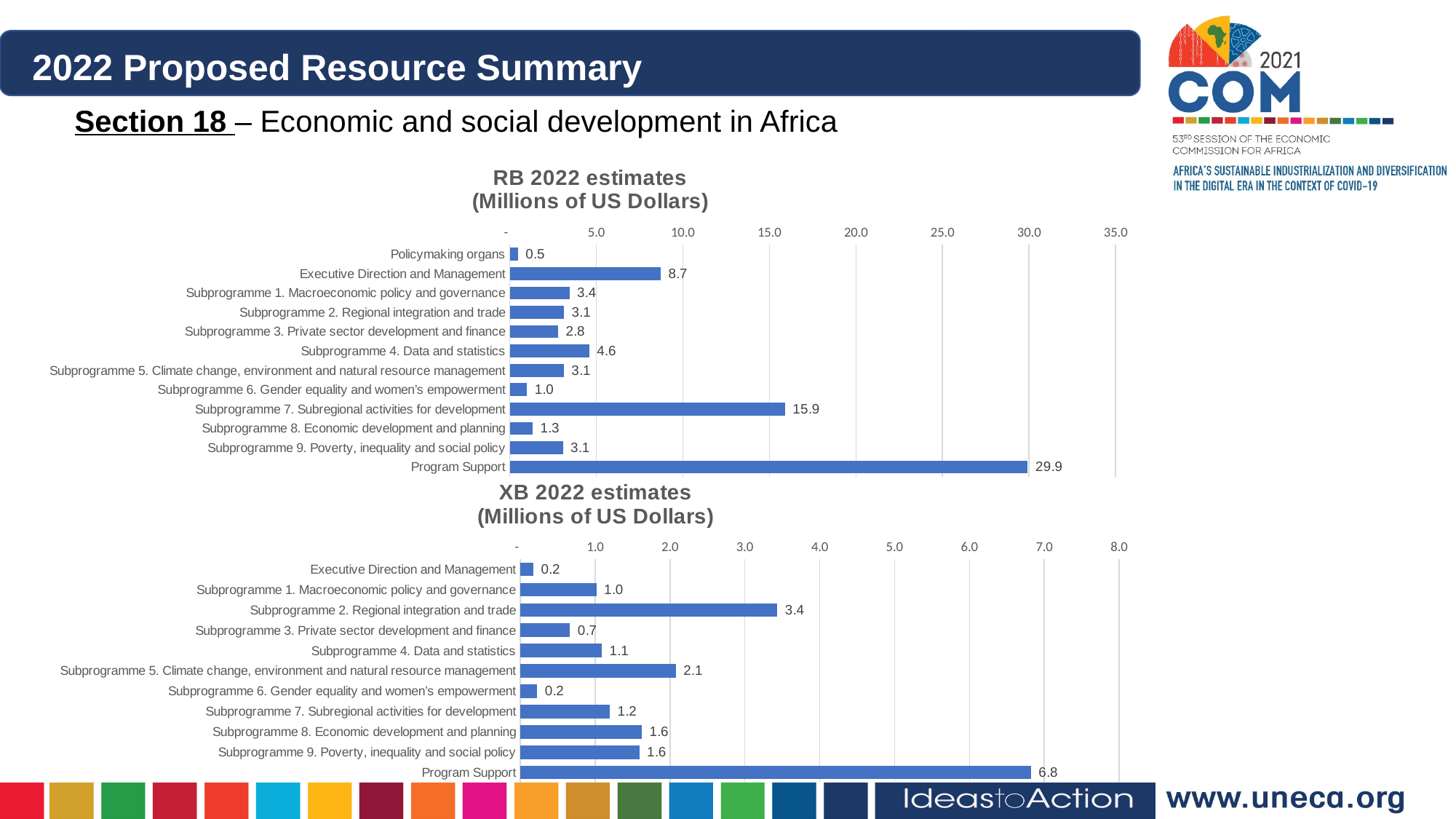
In the XB 2022 estimates chart, how many categories are plotted? 11 In the XB 2022 estimates chart, what is the value for Subprogramme 5. Climate change, environment and natural resource management? 2.1 In the RB 2022 estimates chart, what is the difference between Program Support and Executive Direction and Management? 21.2 In the RB 2022 estimates chart, how many categories are plotted? 12 In the RB 2022 estimates chart, what is the value for Subprogramme 7. Subregional activities for development? 15.9 What kind of chart is the XB 2022 estimates chart? Bar chart What unit is stated in the title of the RB 2022 estimates chart? Millions of US Dollars In the XB 2022 estimates chart, which is larger, Subprogramme 2. Regional integration and trade or Subprogramme 8. Economic development and planning? Subprogramme 2. Regional integration and trade In the RB 2022 estimates chart, which category has the lowest value? Policymaking organs In the RB 2022 estimates chart, which category has the highest value? Program Support In the RB 2022 estimates chart, is the value for Subprogramme 4. Data and statistics greater or less than 5.0? less In the XB 2022 estimates chart, which category has the highest value? Program Support